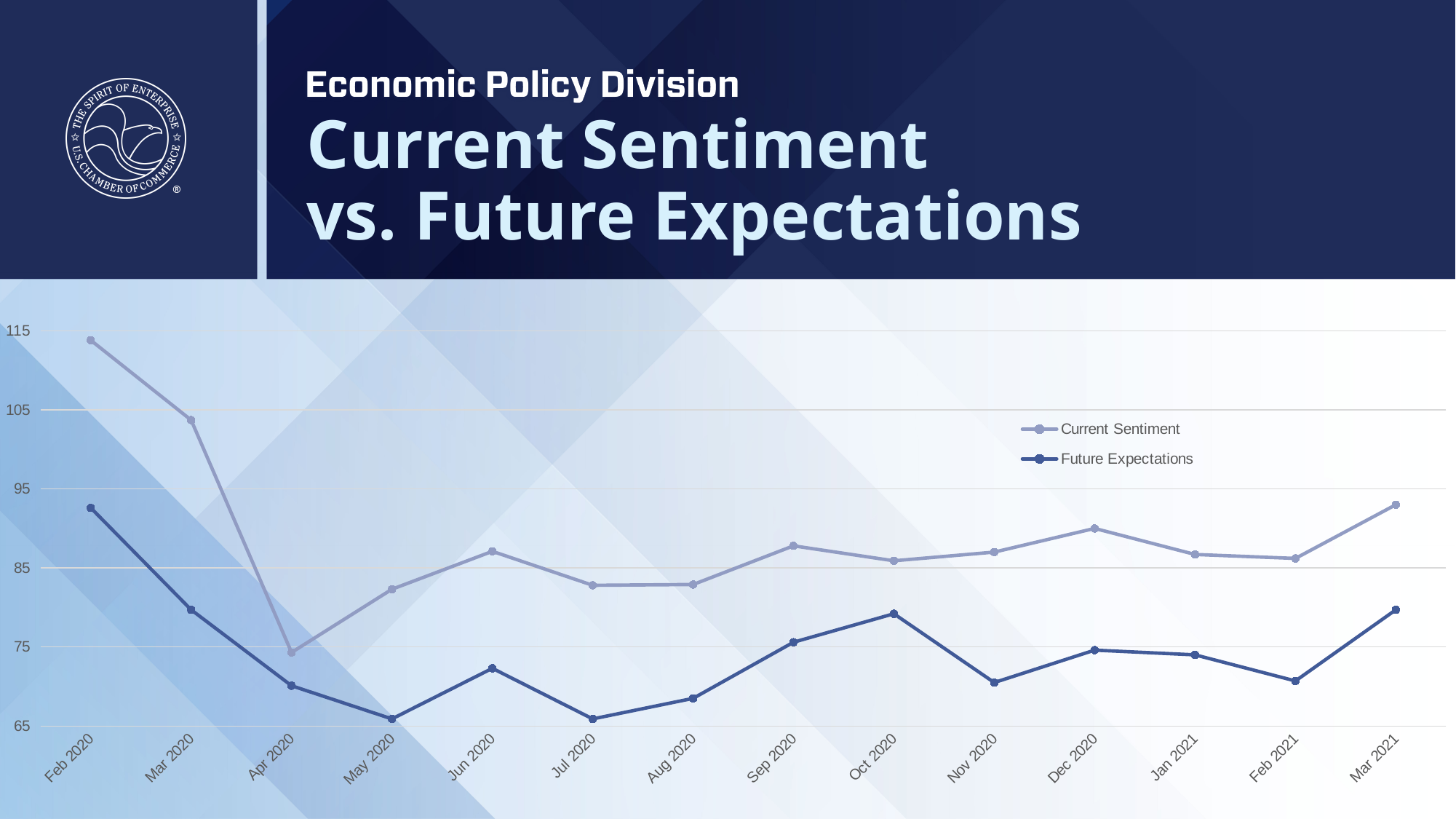
In which month is Future Expectations highest? Feb 2020 Does Current Sentiment rise or fall from Feb 2020 to Apr 2020? Fall How many months are plotted along the x axis? 14 What are the two series named in the legend? Current Sentiment and Future Expectations In Mar 2021, which series has the higher value, Current Sentiment or Future Expectations? Current Sentiment What kind of chart is shown on the slide? Line chart In which month is Current Sentiment lowest? Apr 2020 Is the Future Expectations value for Apr 2020 greater or less than 75? less How many series does the legend list? 2 Is the Current Sentiment value for Feb 2020 greater or less than 105? greater In which month is Current Sentiment highest? Feb 2020 Is the Current Sentiment value for Mar 2021 greater or less than 85? greater